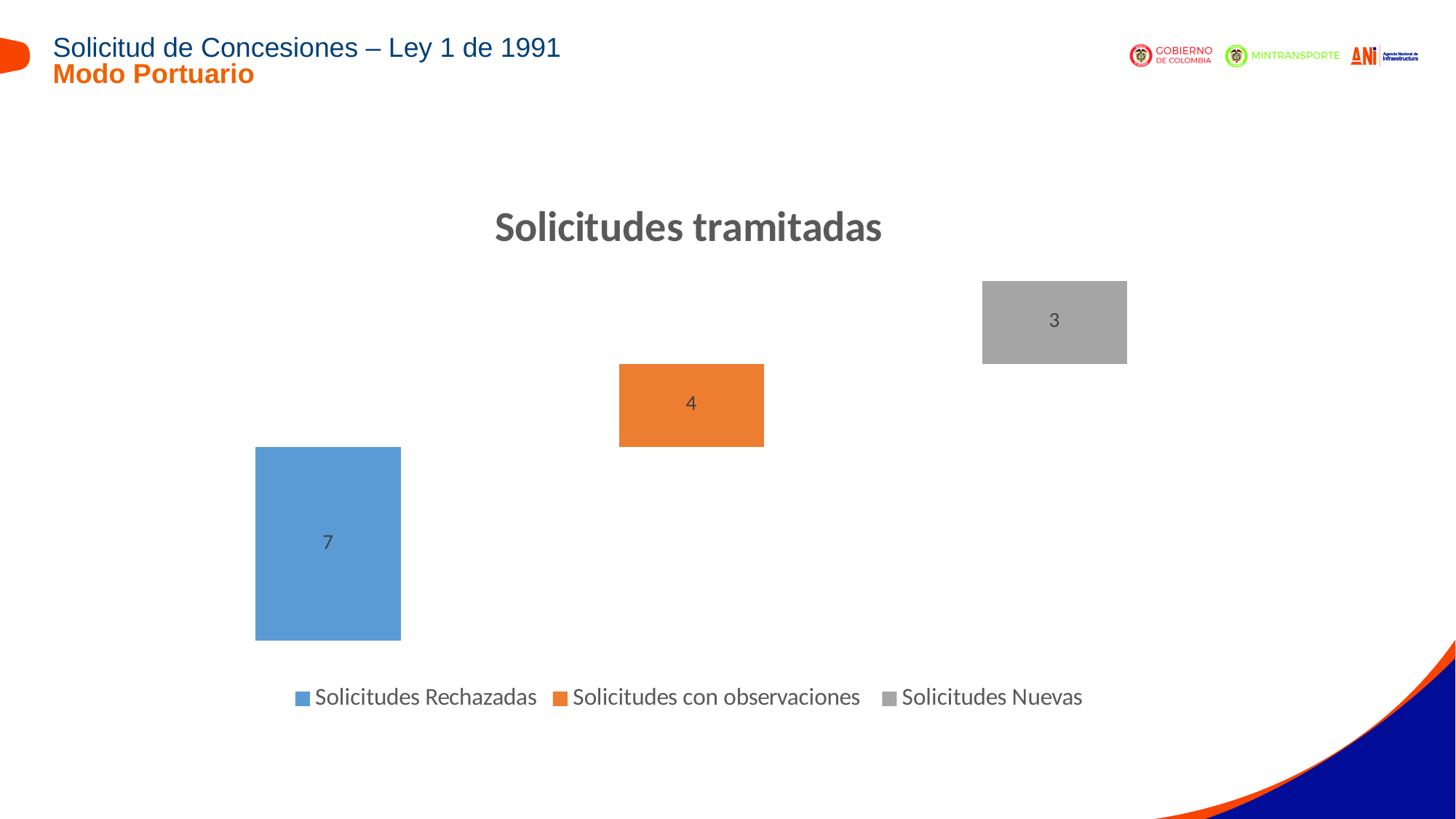
Which series has the highest value? Solicitudes Rechazadas How many series does the legend list? 3 Which is larger, Solicitudes Rechazadas or Solicitudes con observaciones? Solicitudes Rechazadas Which series has the lowest value? Solicitudes Nuevas What is the value for Solicitudes con observaciones? 4 What is the value for Solicitudes Rechazadas? 7 What is the title of the chart? Solicitudes tramitadas What is the value for Solicitudes Nuevas? 3 What is the difference between Solicitudes Rechazadas and Solicitudes Nuevas? 4 What is the difference between Solicitudes con observaciones and Solicitudes Nuevas? 1 What kind of chart is shown on the slide? Bar chart What colour is the bar for Solicitudes Nuevas? Grey